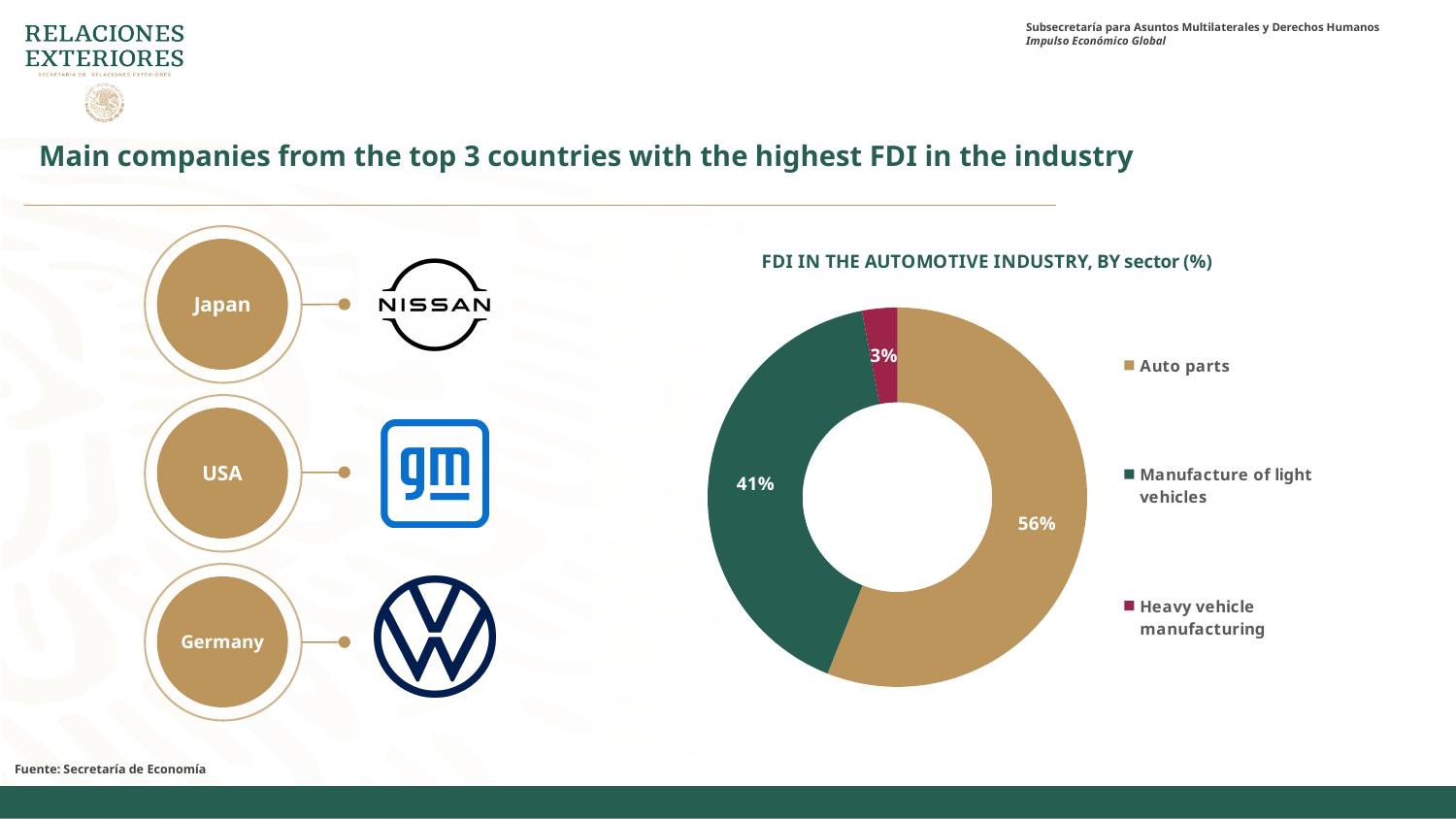
What kind of chart is shown on the slide? Pie chart (doughnut) How many sectors are shown in the chart? 3 Which has a larger share of FDI: Manufacture of light vehicles or Heavy vehicle manufacturing? Manufacture of light vehicles Which sector has the smallest share of FDI in the automotive industry? Heavy vehicle manufacturing How many entries does the chart legend list? 3 What share of FDI in the automotive industry goes to Auto parts? 56% Which sector has the largest share of FDI in the automotive industry? Auto parts What share of FDI goes to Heavy vehicle manufacturing? 3% What is the title of the chart? FDI IN THE AUTOMOTIVE INDUSTRY, BY sector (%) What is the difference in percentage points between the Auto parts share and the Manufacture of light vehicles share? 15 What colour represents Heavy vehicle manufacturing in the chart? Dark red What share of FDI goes to Manufacture of light vehicles? 41%